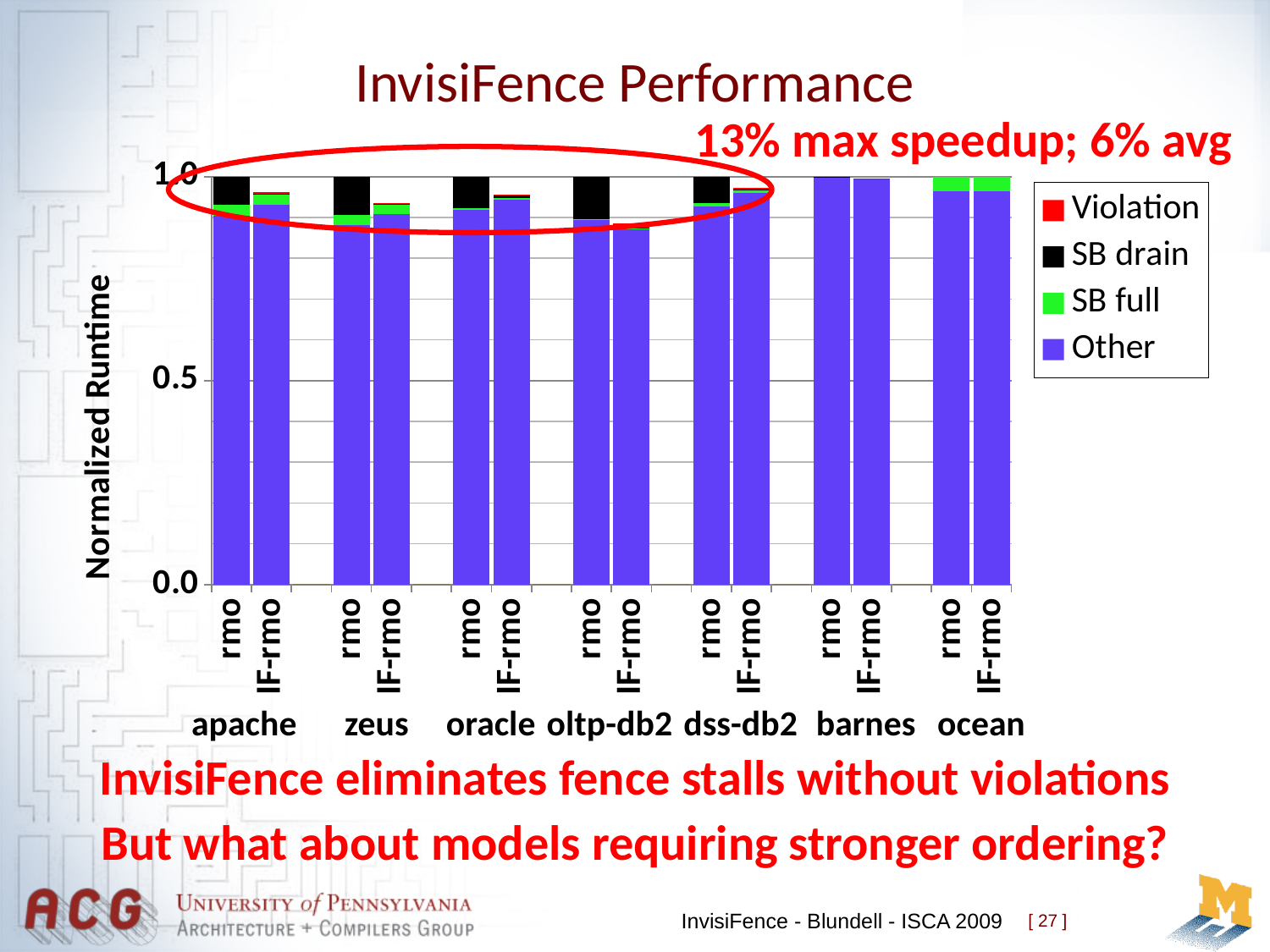
How many benchmark groups are shown along the x axis? 7 Is the total normalized runtime for the IF-rmo bar of oltp-db2 greater or less than 1.0? less For apache, which bar has the lower total normalized runtime, rmo or IF-rmo? IF-rmo What is the label of the y axis? Normalized Runtime How many series does the legend list? 4 How many bars are plotted in total? 14 Is the 'Other' portion of the rmo bar for barnes greater or less than 0.5? greater Which benchmark's rmo bar has the largest SB drain segment? oltp-db2 What kind of chart is shown on the slide? Stacked bar chart Which series makes up the largest portion of every bar? Other What is the title of the chart? InvisiFence Performance For oltp-db2, which bar has the higher total normalized runtime, rmo or IF-rmo? rmo